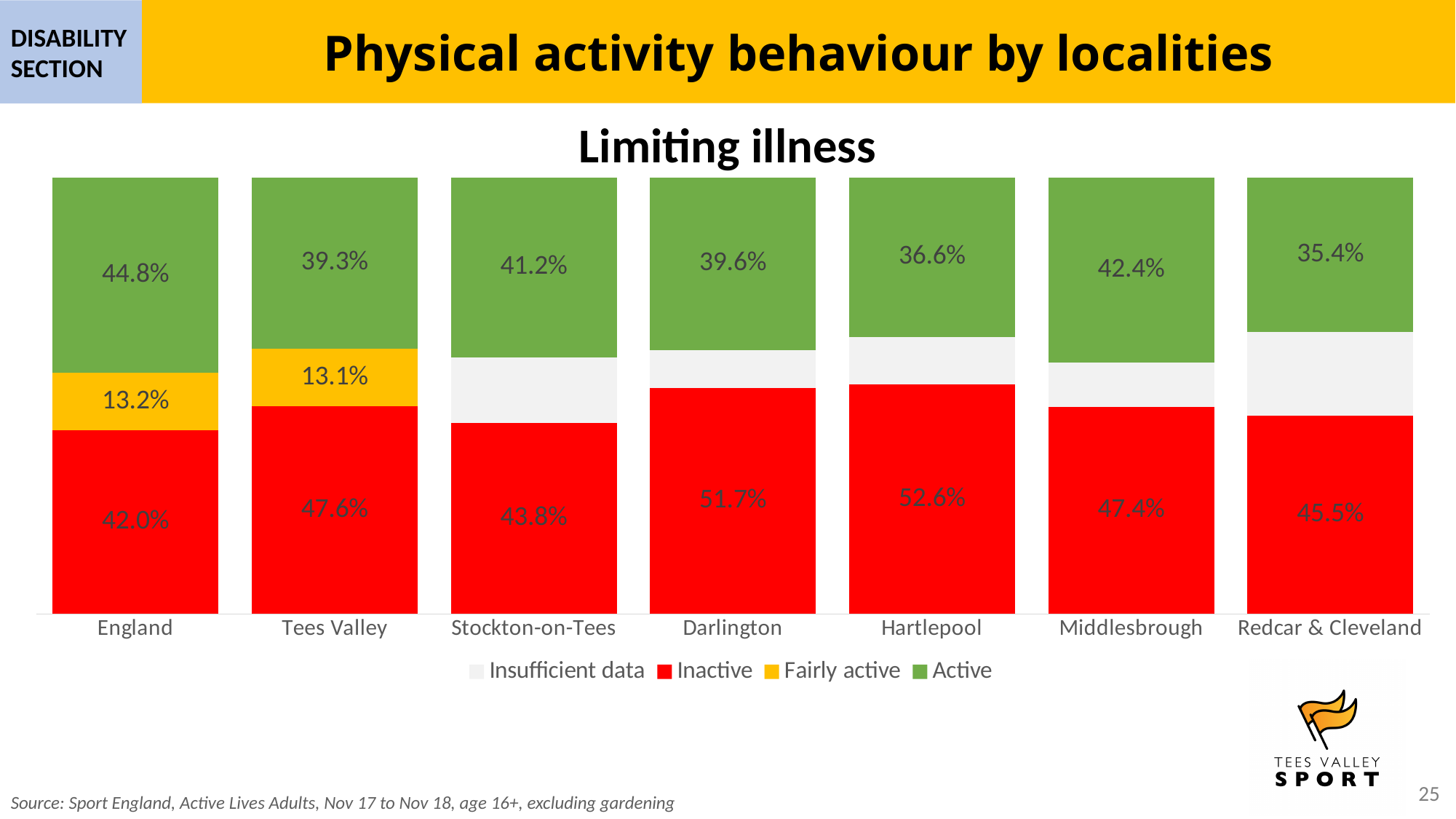
Which has a higher Active percentage, Stockton-on-Tees or Darlington? Stockton-on-Tees What kind of chart is shown on the slide? Stacked bar chart What is the difference between the Inactive percentages for Darlington and England? 9.7% What is the title of the chart? Limiting illness Which colour represents the Inactive series in the legend? Red Which locality has the highest Inactive percentage? Hartlepool How many localities are shown on the x axis? 7 What is the Active percentage for Middlesbrough? 42.4% What is the Fairly active percentage for Tees Valley? 13.1% Which locality has the lowest Active percentage? Redcar & Cleveland How many series does the legend list? 4 What is the Inactive percentage for Hartlepool? 52.6%